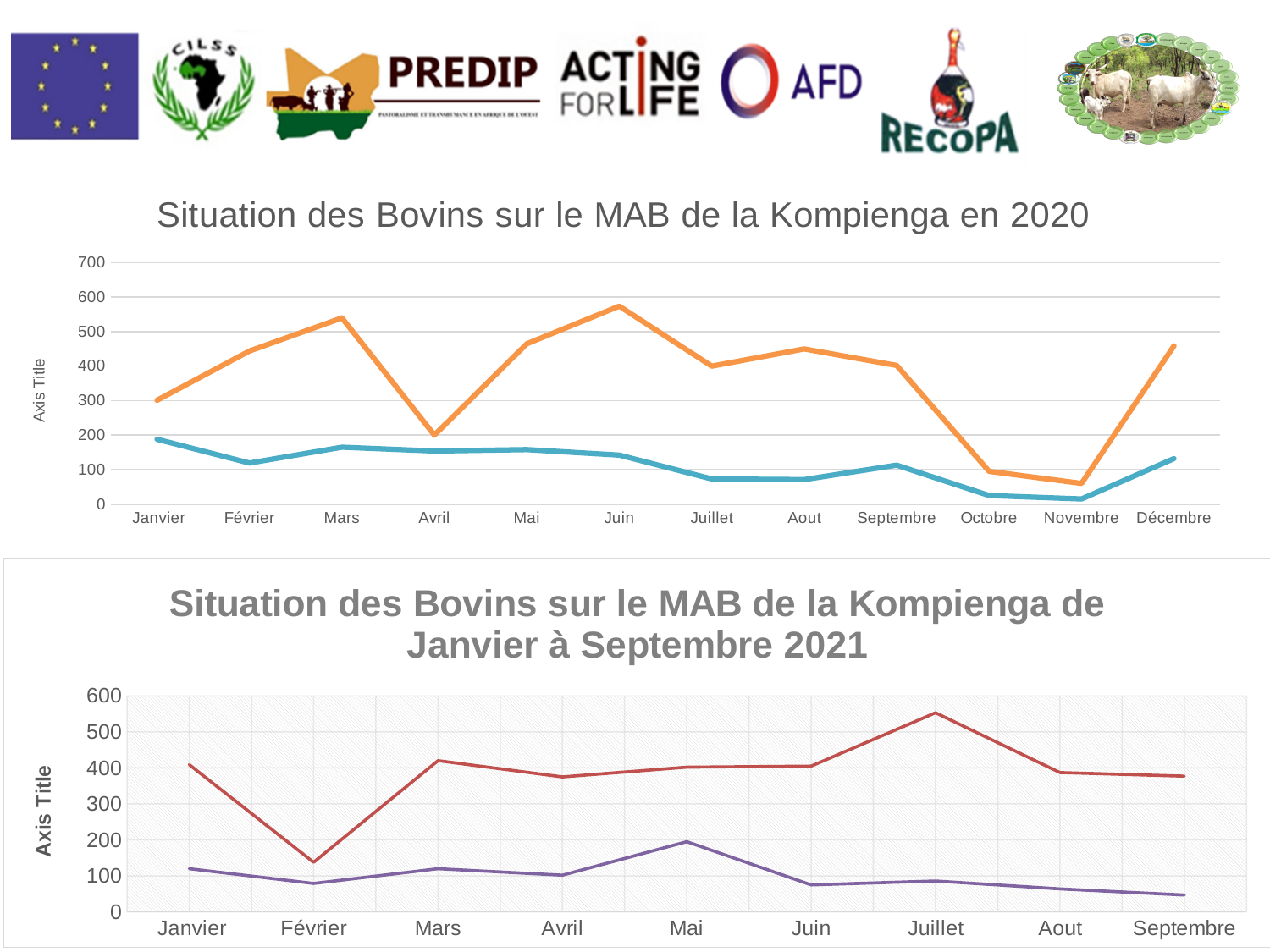
In the top chart (2020), in which month does the orange line reach its lowest value? Novembre In the bottom chart (Janvier à Septembre 2021), in which month does the red line reach its lowest value? Février How many months are shown on the x axis of the bottom chart (Janvier à Septembre 2021)? 9 In the top chart (2020), is the orange line's value for Avril greater or less than 300? less In the top chart (2020), which line is higher in Mars, the orange line or the blue line? Orange line In the bottom chart (Janvier à Septembre 2021), does the red line rise or fall from Juillet to Septembre? Fall In the bottom chart (Janvier à Septembre 2021), is the red line's value for Juillet greater or less than 500? greater In the top chart (2020), is the orange line's value for Juin greater or less than 500? greater In the top chart (2020), in which month does the orange line reach its highest value? Juin In the bottom chart (Janvier à Septembre 2021), in which month does the red line reach its highest value? Juillet What kind of chart is the top chart, 'Situation des Bovins sur le MAB de la Kompienga en 2020'? Line chart How many months are shown on the x axis of the top chart (2020)? 12